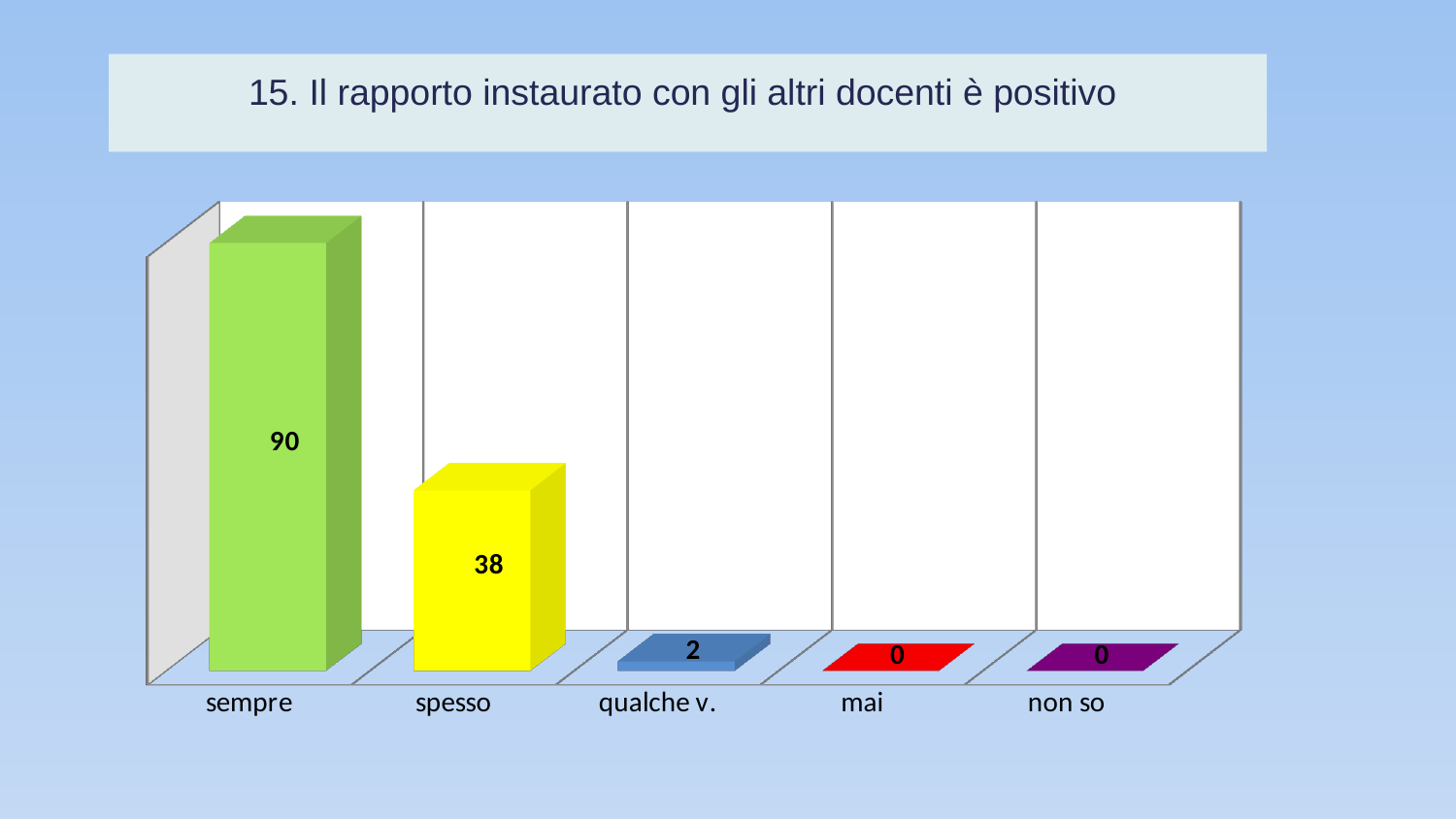
What is the value for "spesso"? 38 What is the total of the values for "sempre", "spesso" and "qualche v."? 130 How many categories are shown on the x axis? 5 Do the values rise or fall from left to right along the x axis? fall What is the value for "mai"? 0 What is the value for "sempre"? 90 What is the value for "qualche v."? 2 What kind of chart is shown on the slide? bar chart Which category has the highest value? sempre What is the title of the chart? 15. Il rapporto instaurato con gli altri docenti è positivo What is the difference between the values for "sempre" and "spesso"? 52 Which is larger, the value for "spesso" or the value for "qualche v."? spesso